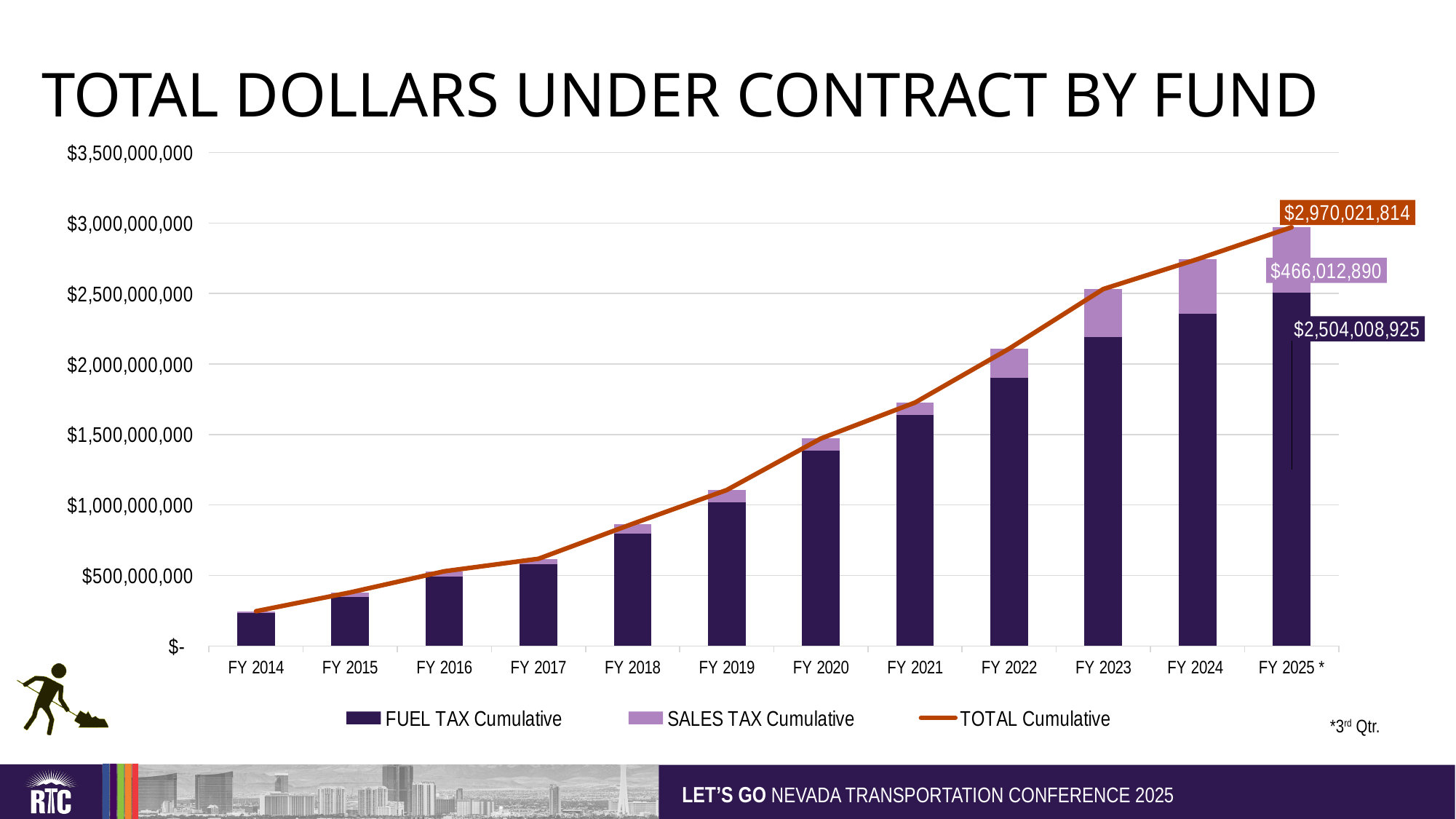
How many fiscal years are shown on the x axis? 12 Which fiscal year has a larger FUEL TAX Cumulative value, FY 2019 or FY 2023? FY 2023 What is the SALES TAX Cumulative value for FY 2025 *? $466,012,890 Which fiscal year has the lowest TOTAL Cumulative value? FY 2014 Does the TOTAL Cumulative line rise or fall from FY 2014 to FY 2025 *? rises What kind of chart is shown on the slide? stacked bar chart with a line Is the FUEL TAX Cumulative value for FY 2020 greater or less than $1,000,000,000? greater What is the TOTAL Cumulative value for FY 2025 *? $2,970,021,814 Which fiscal year has the highest TOTAL Cumulative value? FY 2025 * How many series does the legend list? 3 What is the FUEL TAX Cumulative value for FY 2025 *? $2,504,008,925 For FY 2025 *, how much larger is the FUEL TAX Cumulative value than the SALES TAX Cumulative value? $2,037,996,035